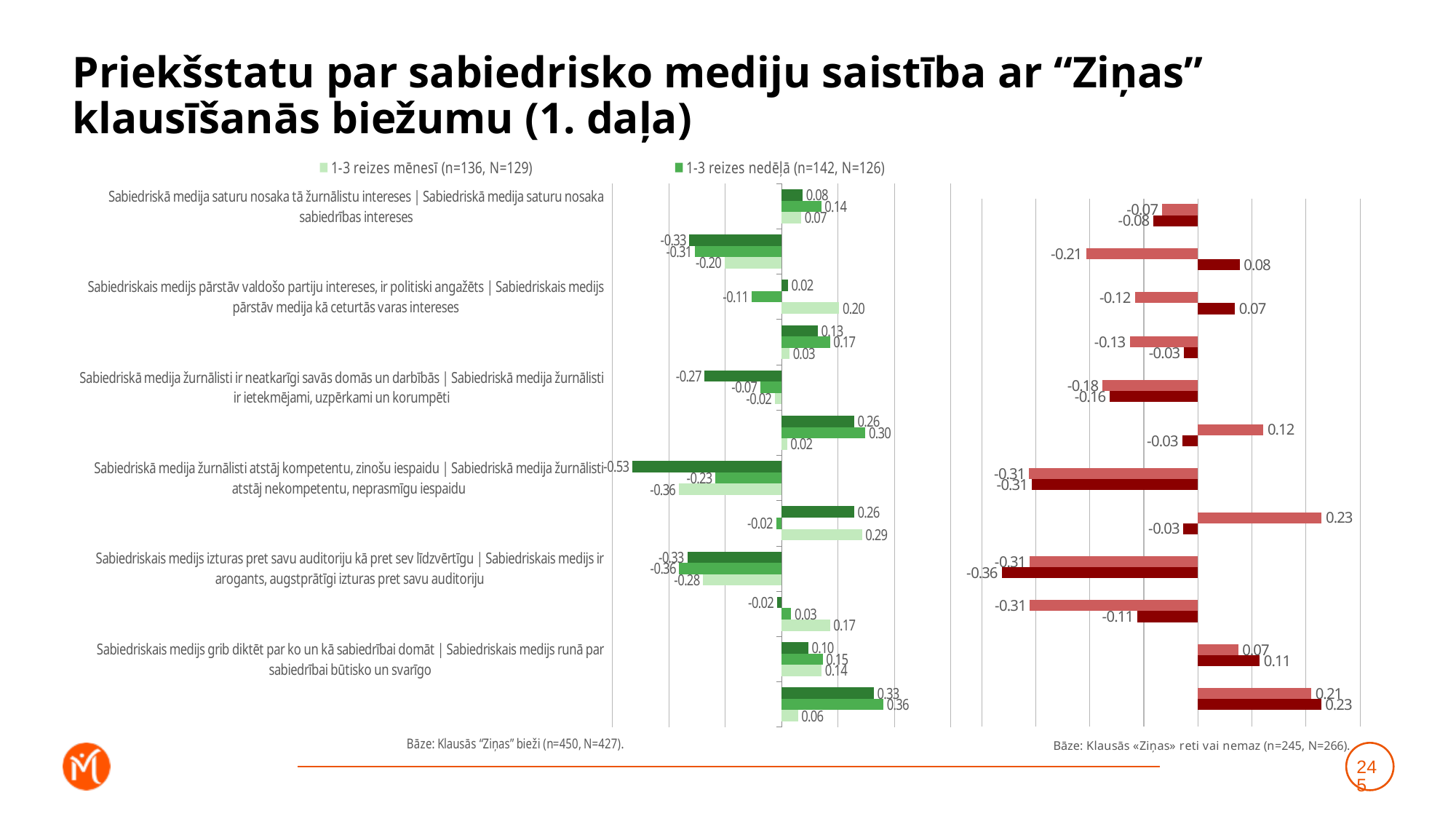
How many series does the legend above the left chart list? 2 What is the difference between the highest (0.36) and lowest (-0.53) data labels in the left chart? 0.89 What kind of chart is shown on the left side of the slide? bar chart What is the first legend entry above the left chart? 1-3 reizes mēnesī (n=136, N=129) In the left (green) chart, what is the highest data label shown? 0.36 Which chart has the lower minimum value, the left chart (-0.53) or the right chart (-0.36)? the left chart How many statement-pair category labels are listed along the left side of the charts? 6 In the right (red) chart, what is the lowest data label shown? -0.36 How many charts are on the slide? 2 In the left (green) chart, what is the lowest data label shown? -0.53 What is the second legend entry above the left chart? 1-3 reizes nedēļā (n=142, N=126) In the right (red) chart, what is the highest data label shown? 0.23